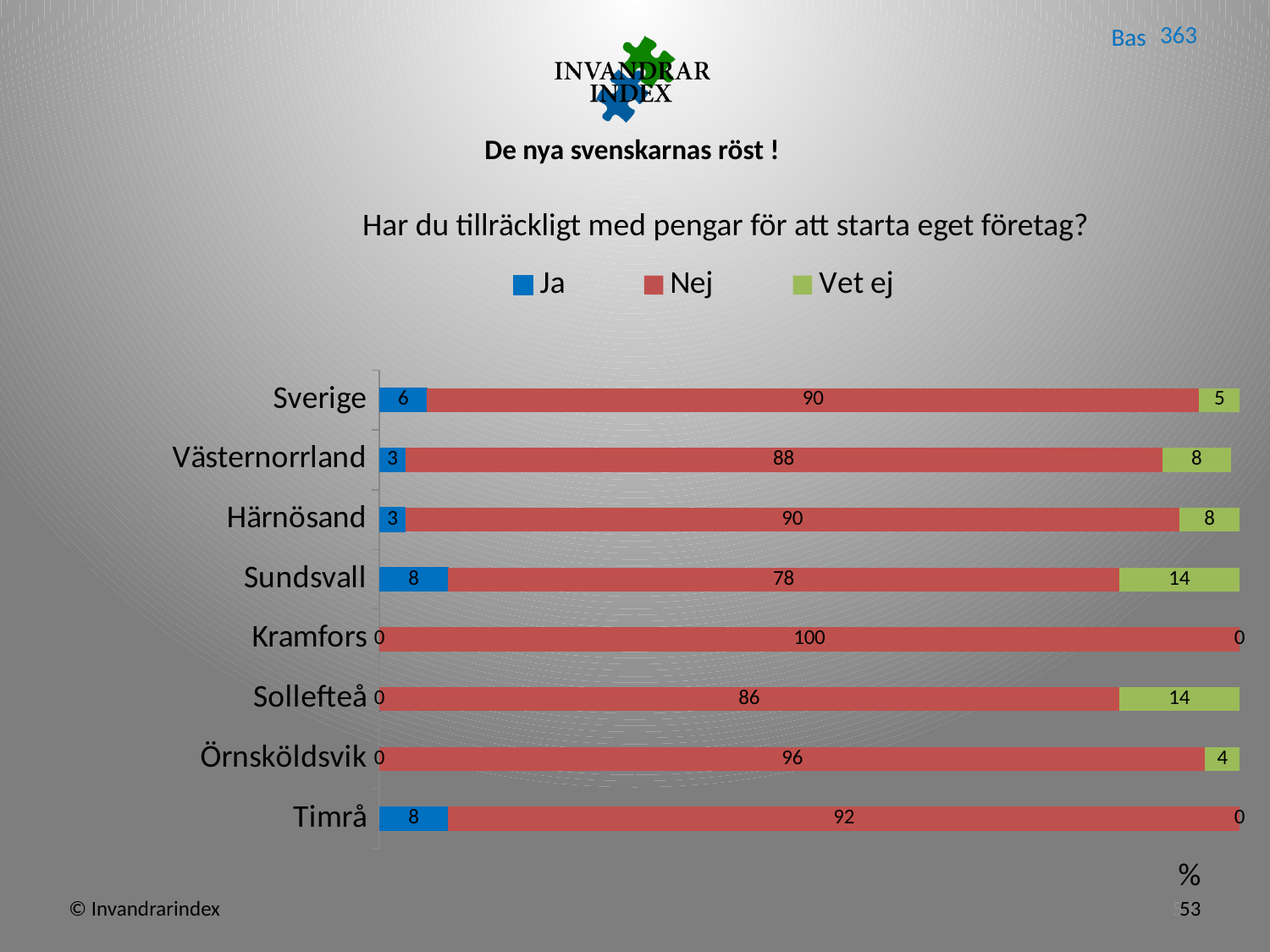
How many categories are shown on the chart? 8 Which category has the lowest Nej value? Sundsvall Which category has the highest Nej value? Kramfors What is the difference between the Nej values for Timrå and Sollefteå? 6 How many series does the legend list? 3 What is the Ja value for Sverige? 6 What kind of chart is shown on the slide? Stacked bar chart What is the total of the stacked bar for Sundsvall? 100 What is the Nej value for Sundsvall? 78 Which is larger, the Vet ej value for Sundsvall or for Örnsköldsvik? Sundsvall What question is shown as the chart title? Har du tillräckligt med pengar för att starta eget företag? What is the Vet ej value for Västernorrland? 8